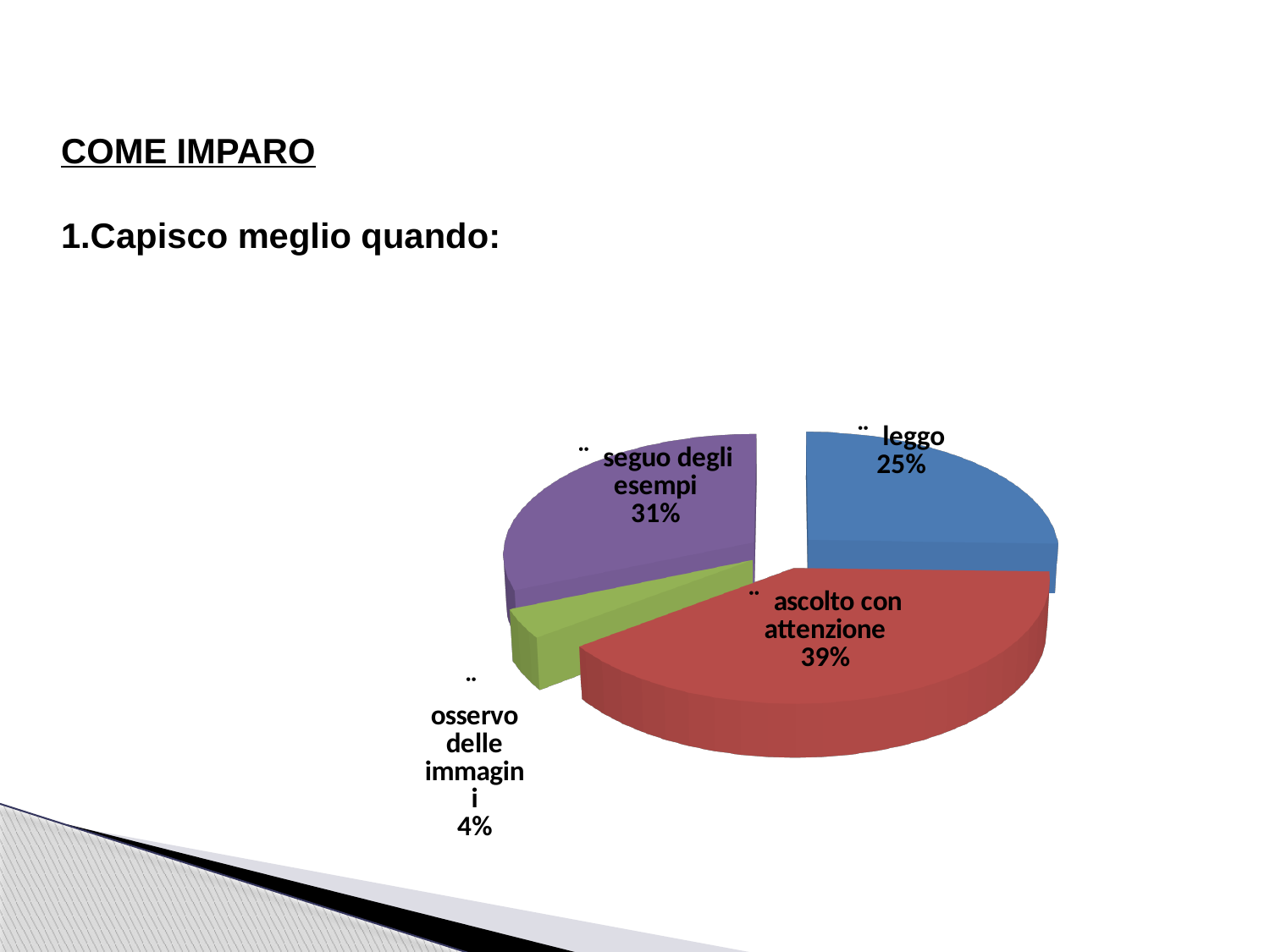
What percentage of the pie is labelled "leggo"? 25% Which is larger, the share for "seguo degli esempi" or the share for "leggo"? seguo degli esempi What percentage of the pie is labelled "seguo degli esempi"? 31% What colour is the slice for "seguo degli esempi"? purple How many slices does the pie chart have? 4 What percentage of the pie is labelled "osservo delle immagini"? 4% What colour is the slice for "ascolto con attenzione"? red Which slice of the pie is the smallest? osservo delle immagini Which slice of the pie is the largest? ascolto con attenzione What is the difference in percentage points between "ascolto con attenzione" and "leggo"? 14 What percentage of the pie is labelled "ascolto con attenzione"? 39% What kind of chart is shown on the slide? pie chart